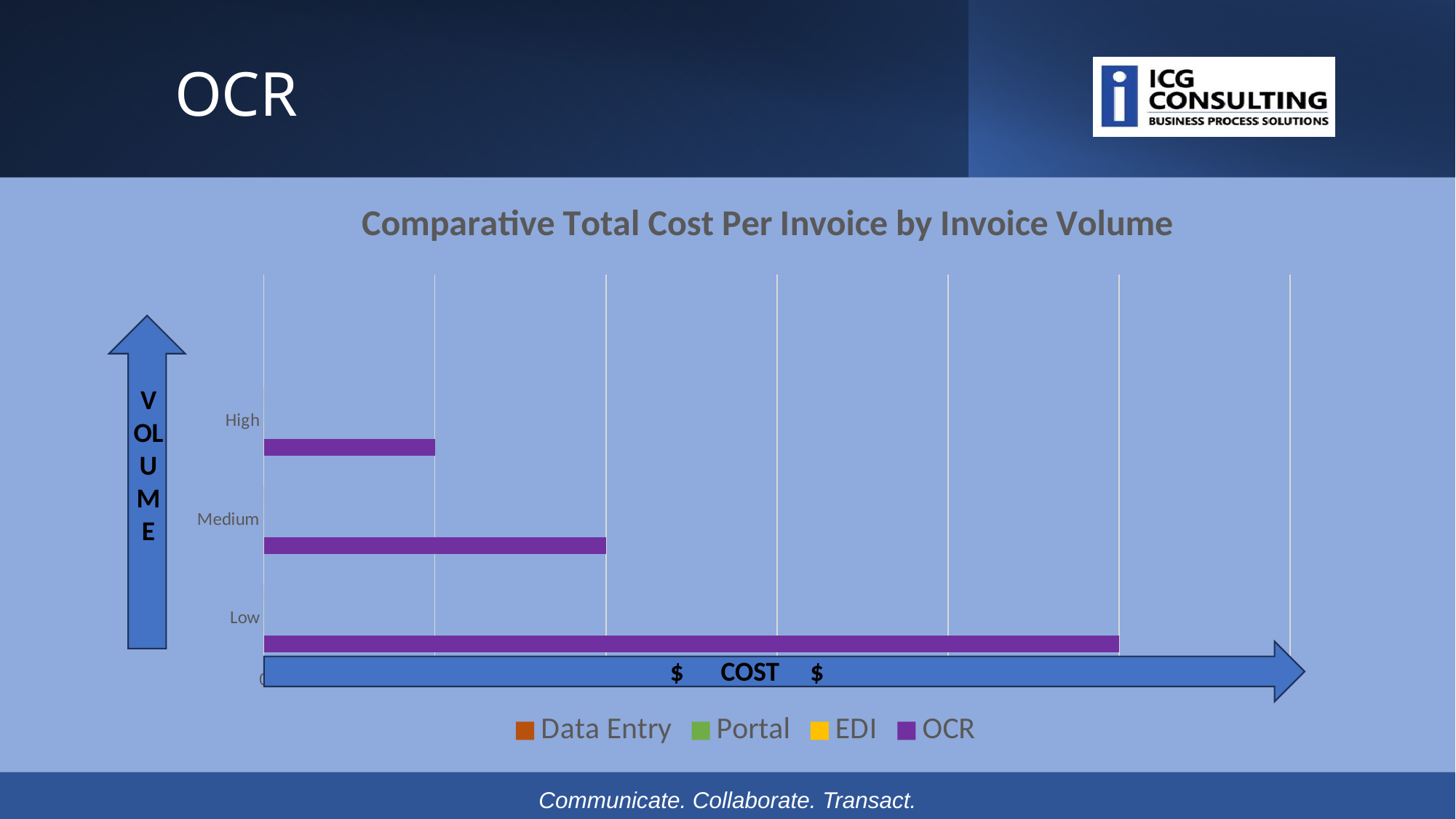
What is the title of the chart? Comparative Total Cost Per Invoice by Invoice Volume Which series is the only one with visible bars on the chart? OCR Is the OCR bar longer for Medium volume or for High volume? Medium How many volume categories are shown on the chart's vertical axis? 3 How many series does the chart legend list? 4 Which volume category has the longest OCR bar? Low What kind of chart is shown on the slide? bar chart As invoice volume increases from Low to High, does the OCR cost per invoice rise or fall? fall Which volume category has the shortest OCR bar? High Which series in the legend is shown in purple? OCR Is the OCR bar longer for Low volume or for Medium volume? Low